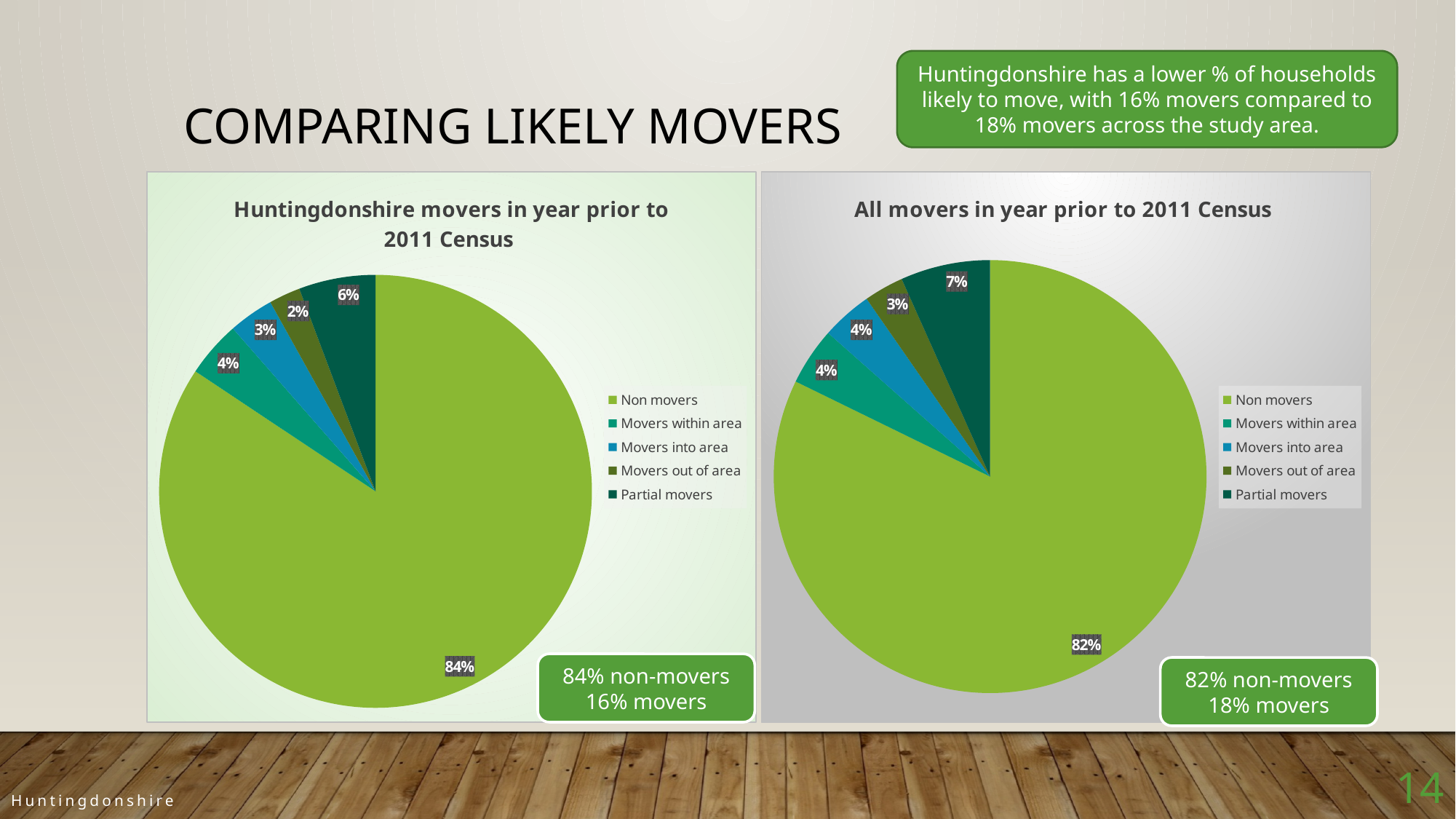
In the 'Huntingdonshire movers in year prior to 2011 Census' chart, which category has the smallest slice? Movers out of area In the 'Huntingdonshire movers in year prior to 2011 Census' chart, what is the value for Movers out of area? 2% In the 'Huntingdonshire movers in year prior to 2011 Census' chart, which is larger: Movers within area or Movers into area? Movers within area In the 'Huntingdonshire movers in year prior to 2011 Census' chart, what is the value for Partial movers? 6% In the 'Huntingdonshire movers in year prior to 2011 Census' chart, what share of the pie is Non movers? 84% How many categories does the legend of the 'All movers in year prior to 2011 Census' chart list? 5 In the 'All movers in year prior to 2011 Census' chart, what share of the pie is Non movers? 82% In the 'All movers in year prior to 2011 Census' chart, what is the value for Partial movers? 7% What type of chart is the 'Huntingdonshire movers in year prior to 2011 Census' chart? Pie chart In the 'All movers in year prior to 2011 Census' chart, which category has the largest slice? Non movers In the 'All movers in year prior to 2011 Census' chart, what is the value for Movers within area? 4% What is the difference between the Partial movers value in the 'All movers in year prior to 2011 Census' chart and the Partial movers value in the 'Huntingdonshire movers in year prior to 2011 Census' chart? 1%